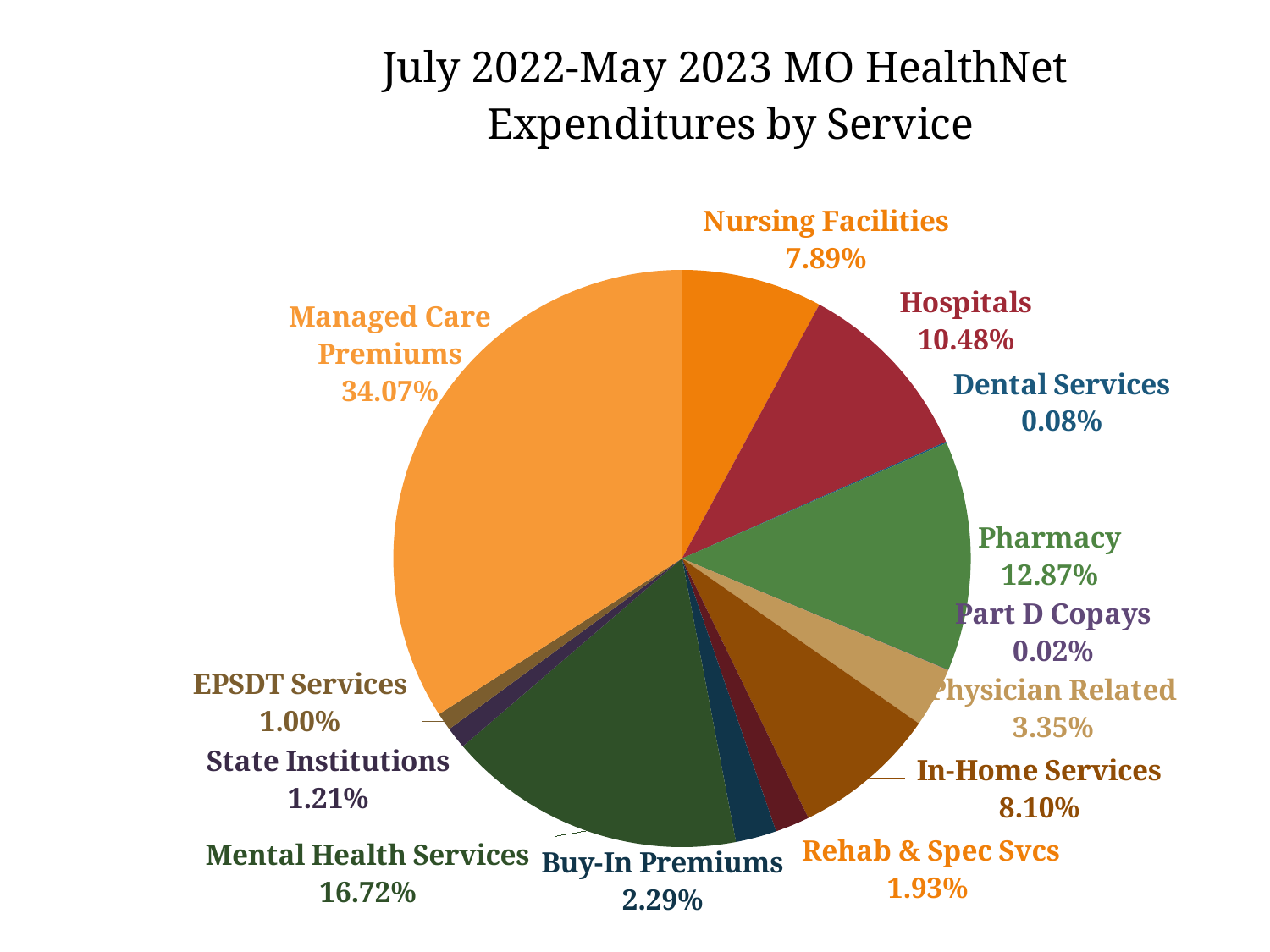
What is the difference in percentage points between Pharmacy and Nursing Facilities? 4.98 What is the value for In-Home Services? 8.10% What percentage is shown for Mental Health Services? 16.72% What percentage is shown for Part D Copays? 0.02% Which service category has the largest share of expenditures? Managed Care Premiums Which service category has the smallest share of expenditures? Part D Copays How many service categories are shown in the pie chart? 13 What is the combined share of Buy-In Premiums and Rehab & Spec Svcs? 4.22% Which is larger, Pharmacy or Hospitals? Pharmacy What is the title of the chart? July 2022-May 2023 MO HealthNet Expenditures by Service What type of chart is shown on the slide? Pie chart What share of expenditures is Managed Care Premiums? 34.07%